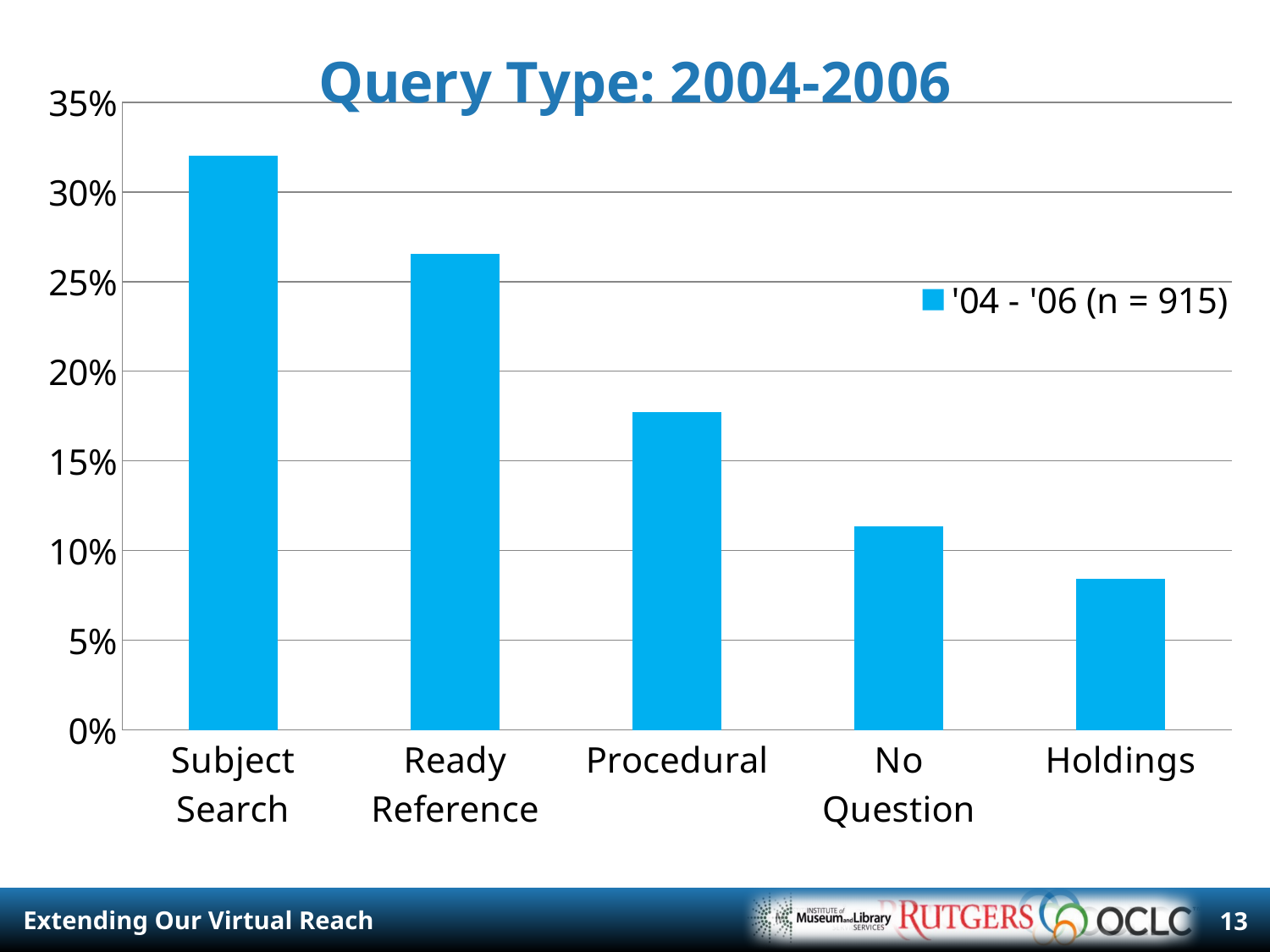
What is the legend entry for the series shown? '04 - '06 (n = 915) How many series does the legend list? 1 Is the value for Ready Reference greater or less than 25%? greater Which query type has the highest percentage? Subject Search What is the title of the chart? Query Type: 2004-2006 Is the value for Subject Search greater or less than 30%? greater Do the values rise or fall moving from left to right across the categories? fall Which query type has the lowest percentage? Holdings Which is larger, the value for No Question or the value for Holdings? No Question How many query type categories are shown on the x axis? 5 What type of chart is shown on the slide? bar chart Is the value for Procedural greater or less than 20%? less